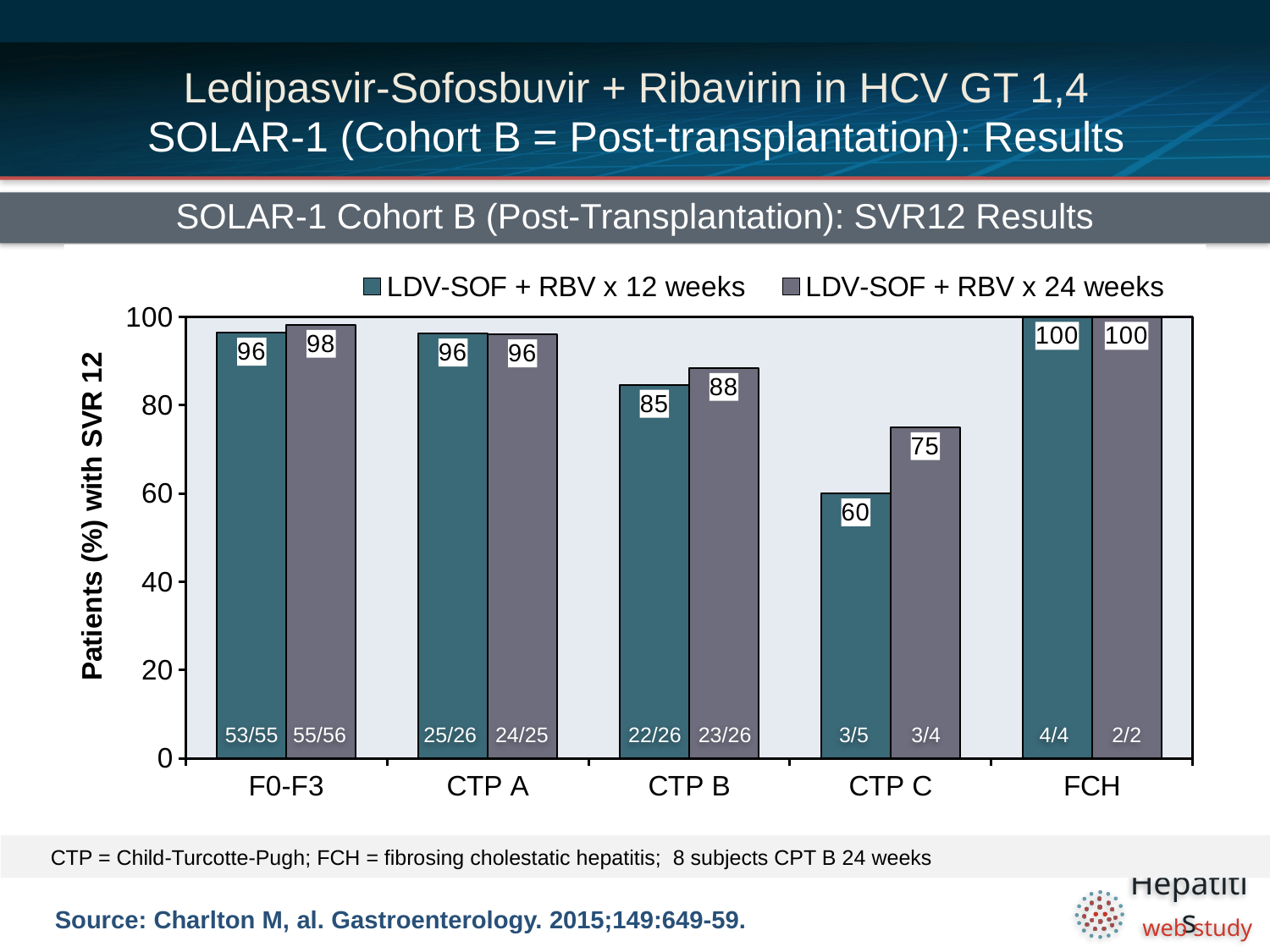
What is the SVR12 rate for CTP B patients treated with LDV-SOF + RBV x 24 weeks? 88 Which category has the lowest SVR12 rate for the LDV-SOF + RBV x 12 weeks series? CTP C How many patient categories are shown on the x axis? 5 For CTP B, which regimen has the higher SVR12 rate, 12 weeks or 24 weeks? LDV-SOF + RBV x 24 weeks Is the SVR12 rate for CTP C with LDV-SOF + RBV x 24 weeks greater or less than 80? less What kind of chart is shown on the slide? bar chart What is the difference between the 24-week and 12-week SVR12 rates for CTP C? 15 What is the SVR12 rate for CTP C patients treated with LDV-SOF + RBV x 12 weeks? 60 How many series does the legend list? 2 What is the SVR12 rate for F0-F3 patients treated with LDV-SOF + RBV x 24 weeks? 98 What is the label of the y axis? Patients (%) with SVR 12 Which category has the highest SVR12 rate for the LDV-SOF + RBV x 24 weeks series? FCH